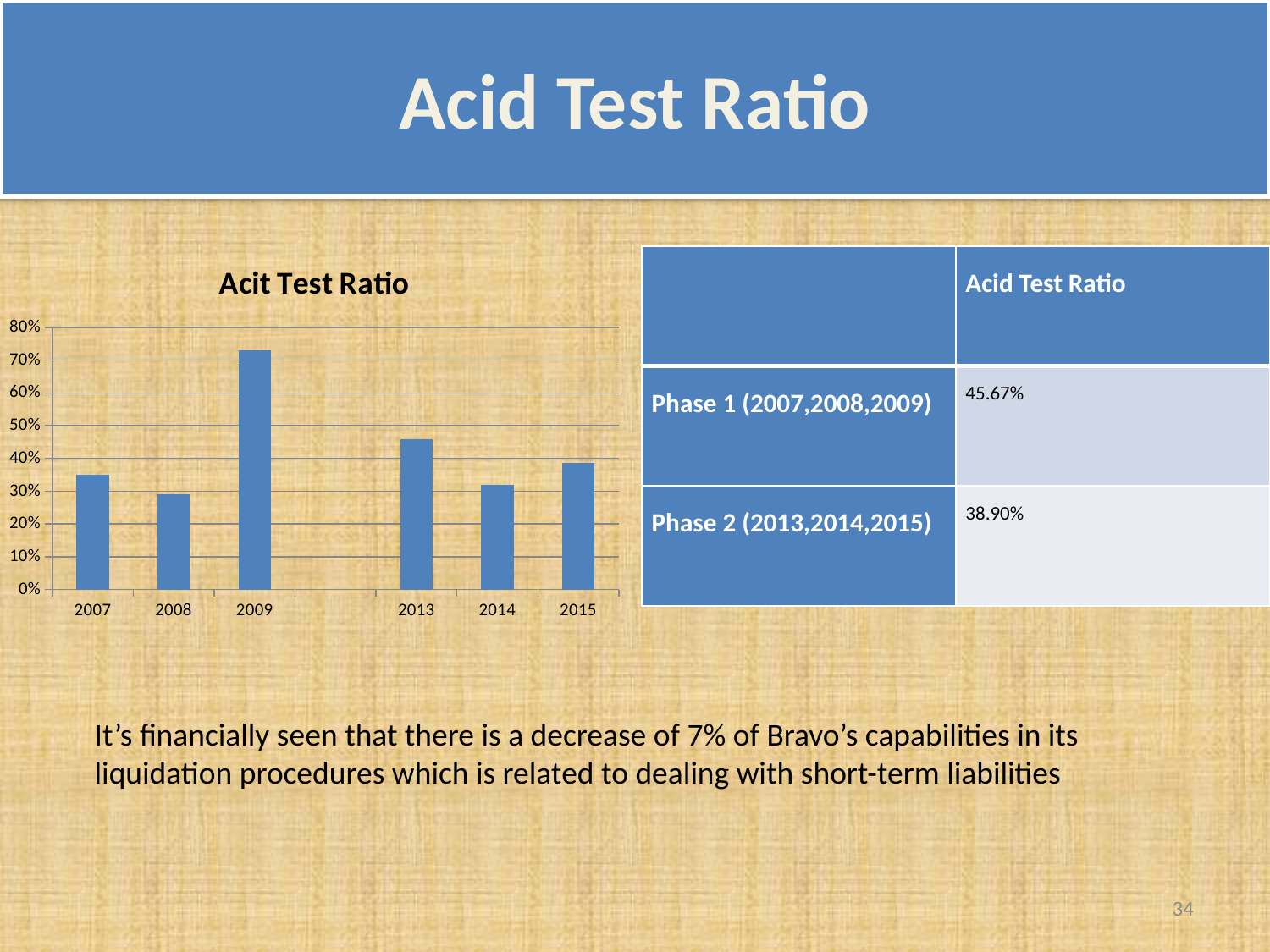
Which year has the larger acid test ratio, 2009 or 2013? 2009 What is the highest value shown on the chart's vertical axis? 80% What kind of chart is shown on the slide? bar chart What is the title of the chart? Acit Test Ratio Is the value for 2009 greater or less than 70%? greater Which year has the larger acid test ratio, 2007 or 2008? 2007 Which year has the highest acid test ratio in the chart? 2009 How many years are plotted in the Acit Test Ratio chart? 6 Is the value for 2013 greater or less than 40%? greater Which year has the lowest acid test ratio in the chart? 2008